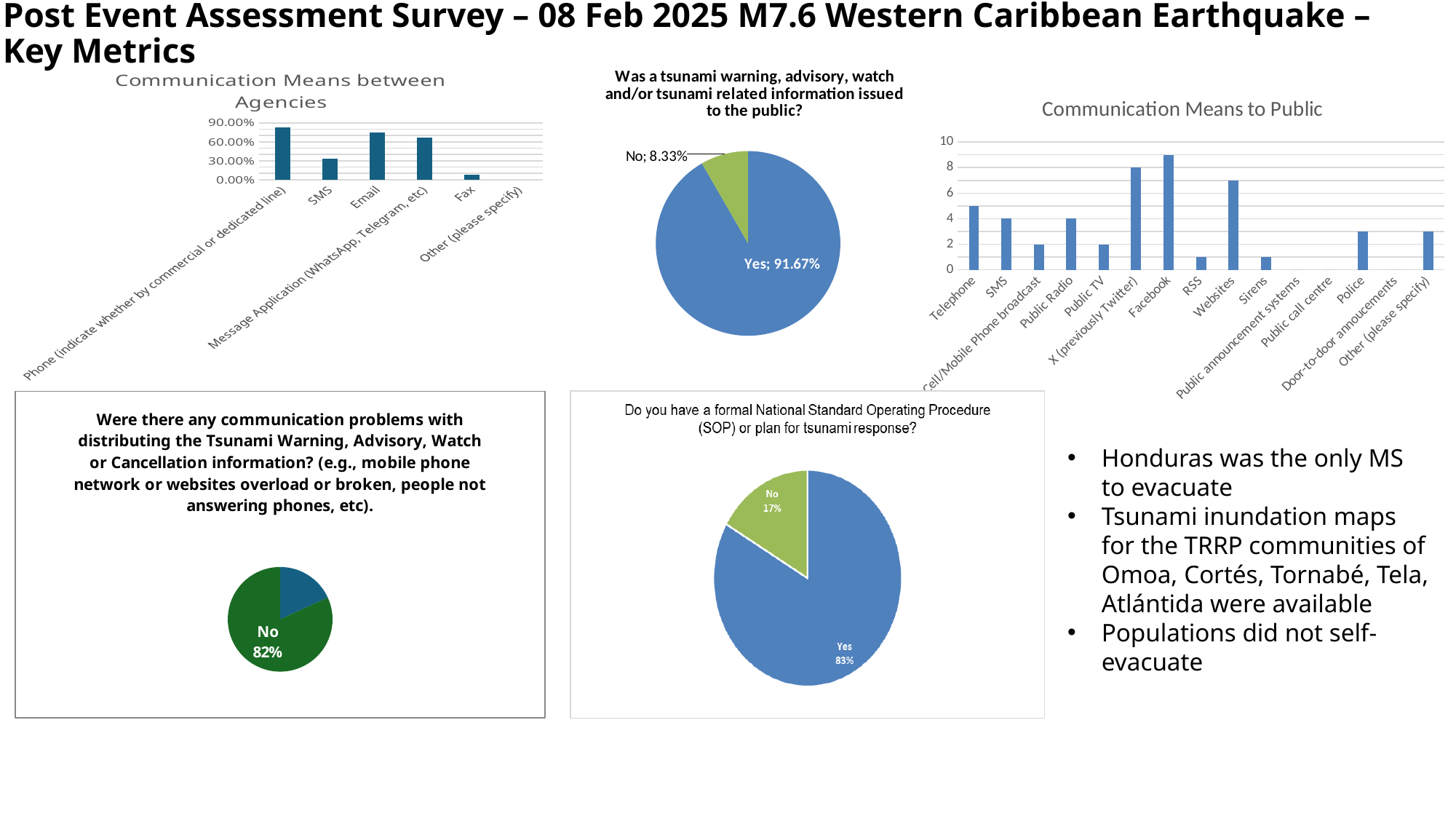
What kind of chart is the 'Communication Means between Agencies' chart? bar chart In the 'Communication Means to Public' chart, what is the value for X (previously Twitter)? 8 In the 'Communication Means to Public' chart, which is larger, Websites or Sirens? Websites In the 'Communication Means between Agencies' chart, is the value for Fax greater or less than 30.00%? less In the 'Communication Means to Public' chart, which category has the highest value? Facebook In the pie chart about communication problems with distributing the Tsunami Warning, Advisory, Watch or Cancellation information, what share answered No? 82% In the 'Communication Means between Agencies' chart, which category has the highest value? Phone (indicate whether by commercial or dedicated line) How many categories are shown on the x axis of the 'Communication Means between Agencies' chart? 6 In the pie chart 'Was a tsunami warning, advisory, watch and/or tsunami related information issued to the public?', what share answered Yes? 91.67% In the pie chart 'Do you have a formal National Standard Operating Procedure (SOP) or plan for tsunami response?', what share answered Yes? 83% In the 'Communication Means between Agencies' chart, is the value for Email greater or less than 60.00%? greater